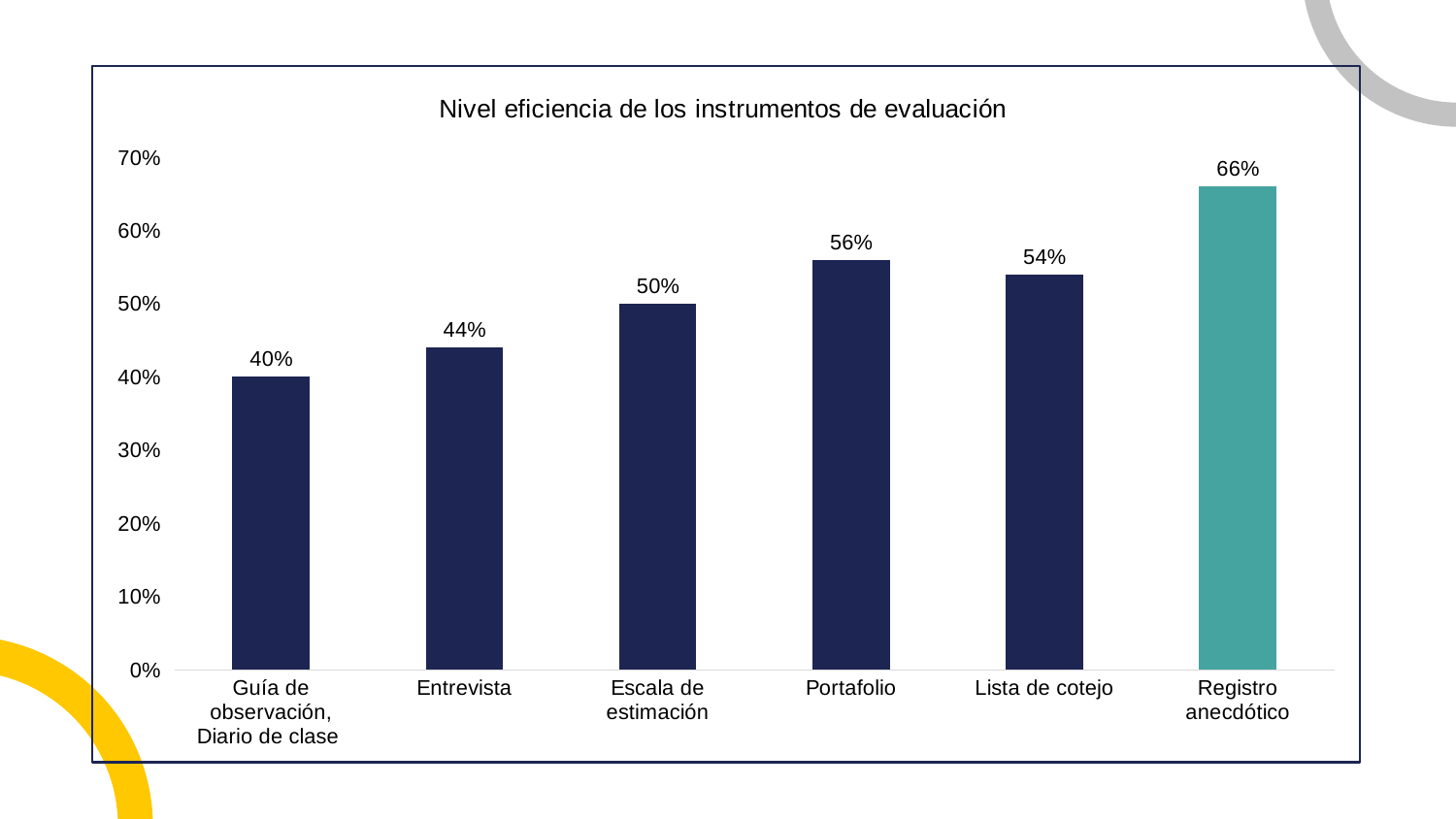
Which category has the highest value? Registro anecdótico What is the value for Portafolio? 56% Which bar is shown in a different colour (teal) from the others? Registro anecdótico What is the value for Entrevista? 44% How many categories are shown on the x axis? 6 What is the title of the chart? Nivel eficiencia de los instrumentos de evaluación Which is larger, the value for Escala de estimación or the value for Entrevista? Escala de estimación What is the difference between the values for Portafolio and Lista de cotejo? 2% What kind of chart is shown on the slide? Bar chart Which category has the lowest value? Guía de observación, Diario de clase What is the difference between the values for Registro anecdótico and Escala de estimación? 16% What is the value for Lista de cotejo? 54%